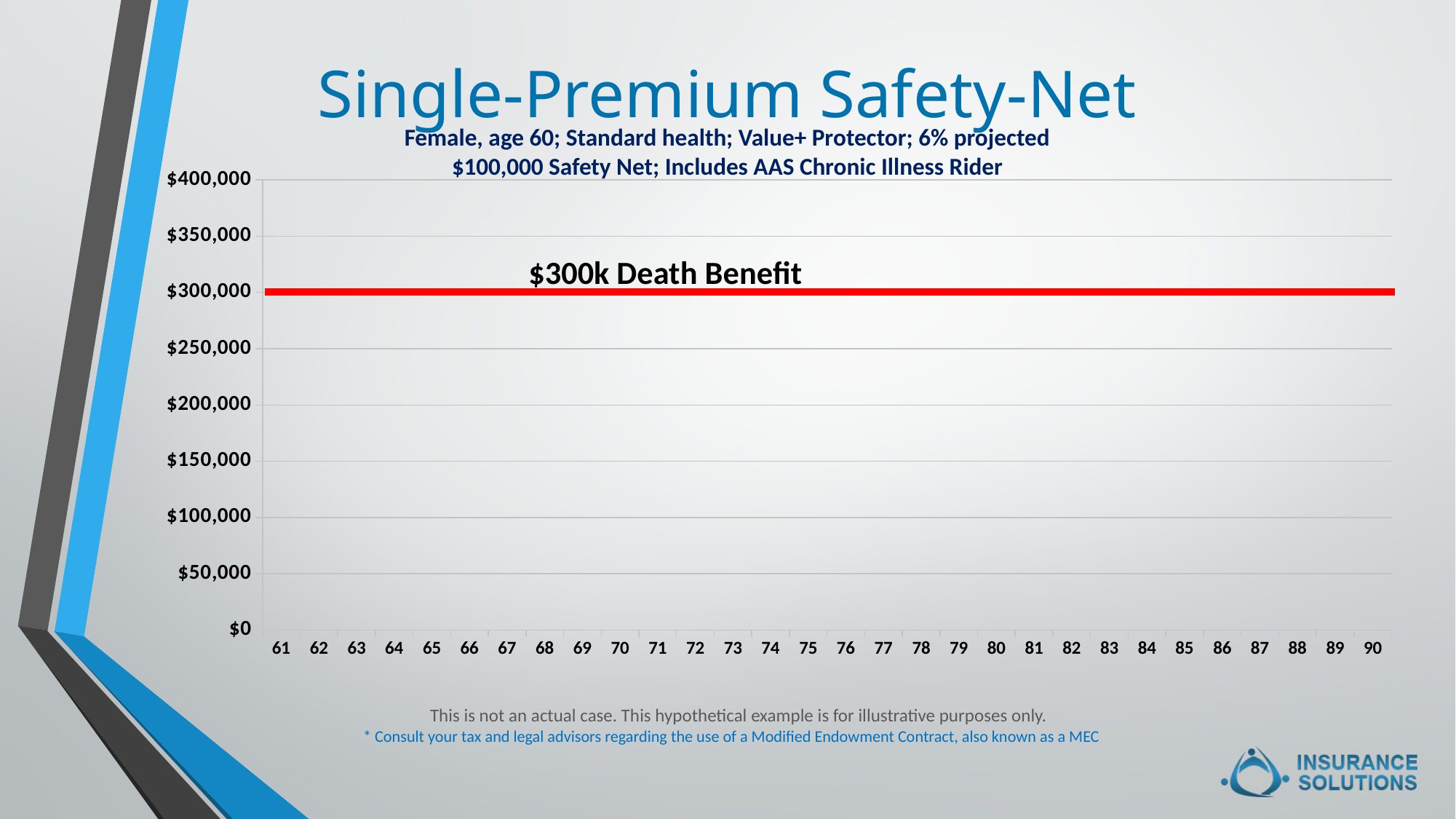
Does the death benefit line rise, fall, or stay flat from age 61 to age 90? stays flat What is the highest value shown on the y axis? $400,000 Is the death benefit value at age 85 greater or less than $350,000? less What kind of chart is shown on the slide? line chart What is the last age shown on the x axis? 90 What is the first age shown on the x axis? 61 Is the death benefit value at age 61 greater or less than $100,000? greater What is the title of the chart? Female, age 60; Standard health; Value+ Protector; 6% projected $100,000 Safety Net; Includes AAS Chronic Illness Rider What label is printed on the red line in the chart? $300k Death Benefit What value does the death benefit line sit at on the y axis? $300,000 How many age categories are shown along the x axis? 30 Is the death benefit value at age 75 greater or less than $250,000? greater